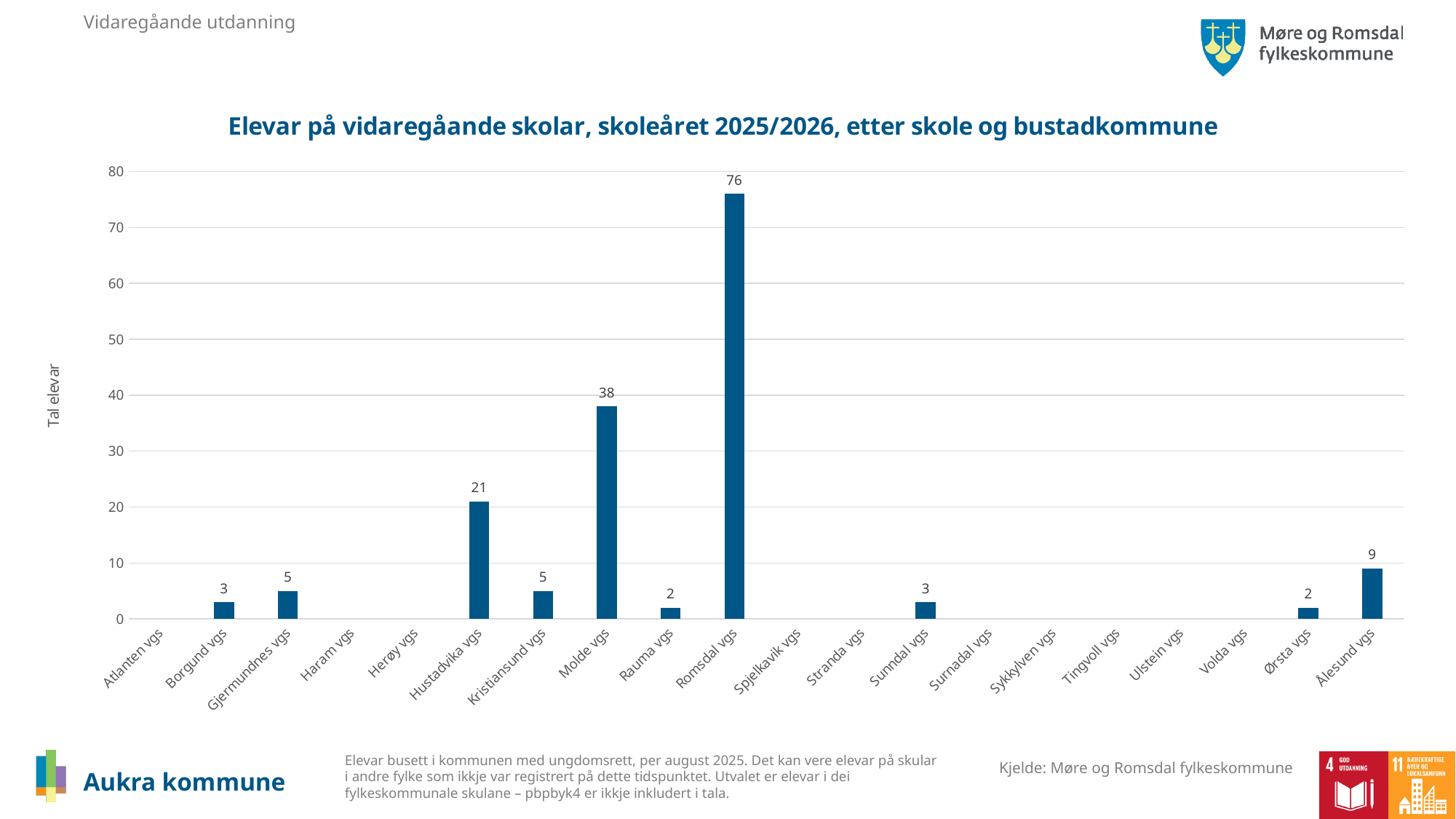
What is the label of the y axis? Tal elevar What kind of chart is shown on the slide? Bar chart Is the value for Molde vgs greater or less than 40? less What is the value for Molde vgs? 38 Which is larger, the value for Gjermundnes vgs or the value for Borgund vgs? Gjermundnes vgs How many schools are listed on the x axis? 20 What is the difference between the values for Romsdal vgs and Molde vgs? 38 How many students are shown for Hustadvika vgs? 21 What is the difference between the values for Hustadvika vgs and Ålesund vgs? 12 Which school has the highest number of students? Romsdal vgs What is the value for Ålesund vgs? 9 How many students are shown for Romsdal vgs? 76